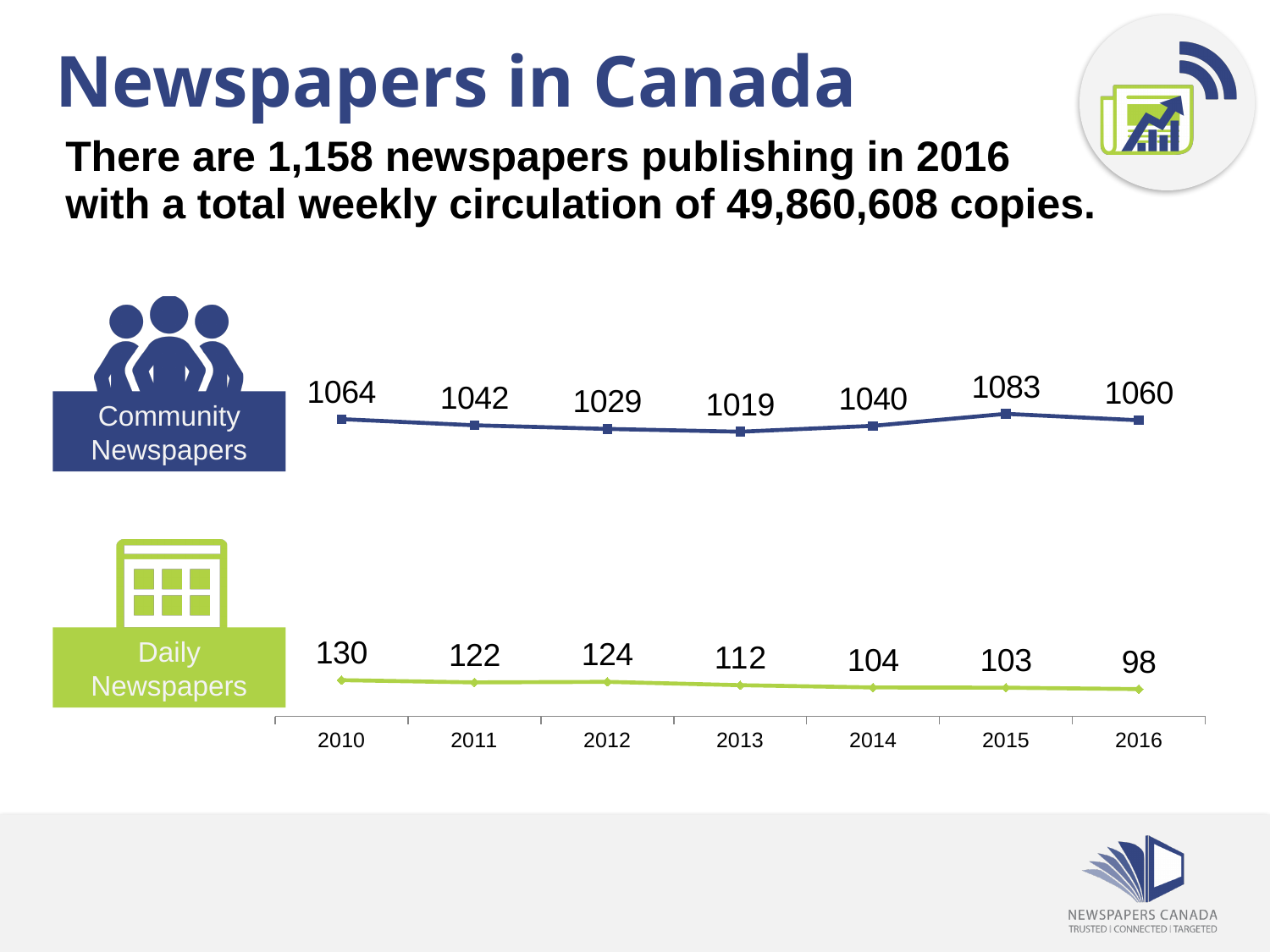
What is the number of Daily Newspapers in 2016? 98 What is the number of Community Newspapers in 2013? 1019 In which year is the number of Daily Newspapers lowest? 2016 In which year is the number of Community Newspapers highest? 2015 How many series are plotted on the chart? 2 Which is larger, the number of Daily Newspapers in 2012 or in 2013? 2012 Does the number of Daily Newspapers generally rise or fall from 2010 to 2016? fall What is the number of Community Newspapers in 2010? 1064 What is the difference between the number of Daily Newspapers in 2010 and in 2016? 32 What colour is the line for Daily Newspapers? green How many years are shown on the x axis? 7 What kind of chart is used to show the newspaper counts? line chart